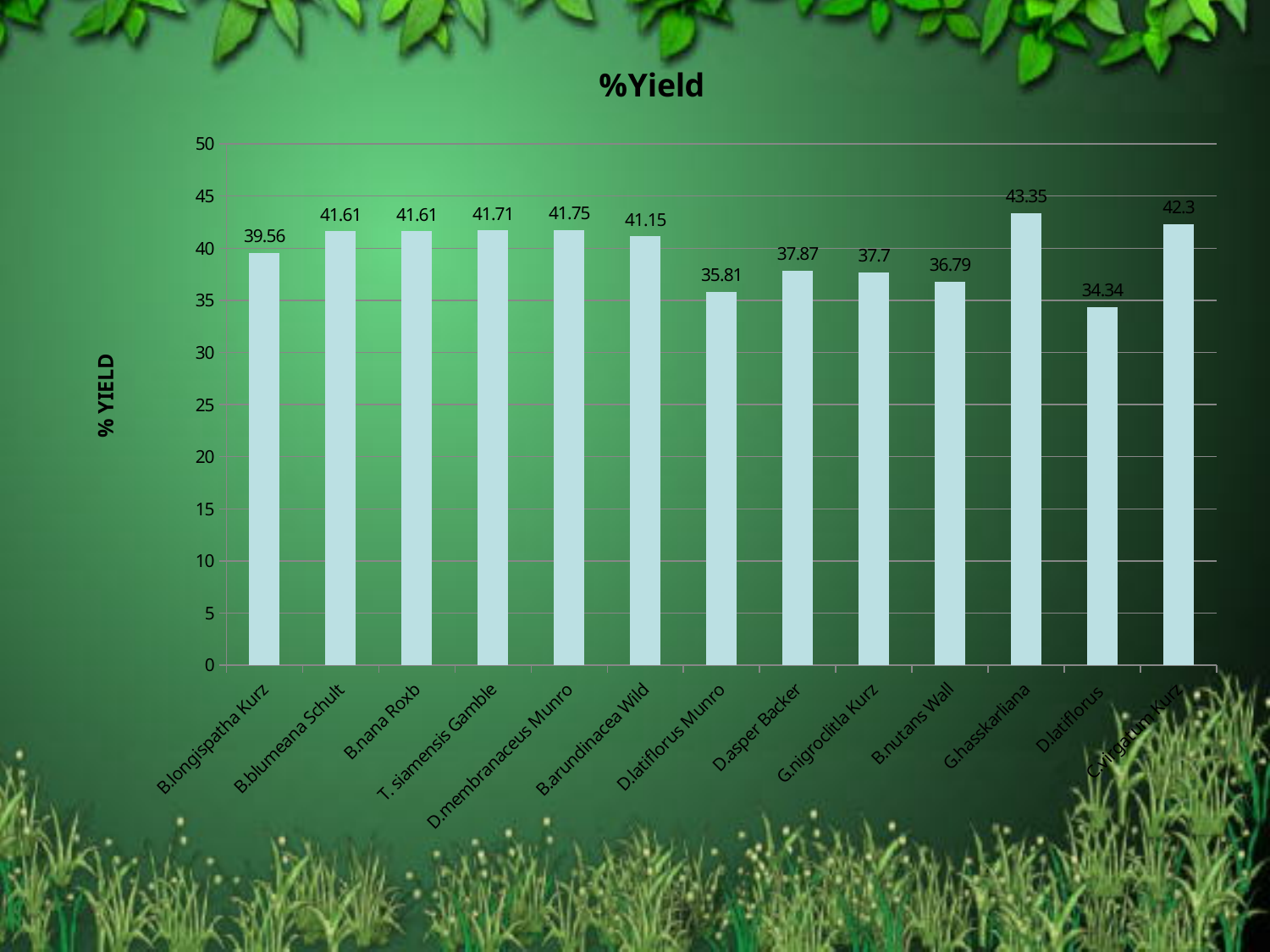
How many species are shown on the chart? 13 Which species has the lowest % yield? D.latiflorus What is the % yield value for B.nutans Wall? 36.79 Which species has the highest % yield? G.hasskarliana What is the difference in % yield between G.hasskarliana and D.latiflorus? 9.01 What is the % yield value for D.membranaceus Munro? 41.75 Which has a higher % yield, D.asper Backer or D.latiflorus Munro? D.asper Backer What is the difference in % yield between T. siamensis Gamble and B.arundinacea Wild? 0.56 What is the % yield value for D.latiflorus Munro? 35.81 What is the % yield value for B.longispatha Kurz? 39.56 What type of chart is shown on the slide? Bar chart What is the title of the chart? %Yield